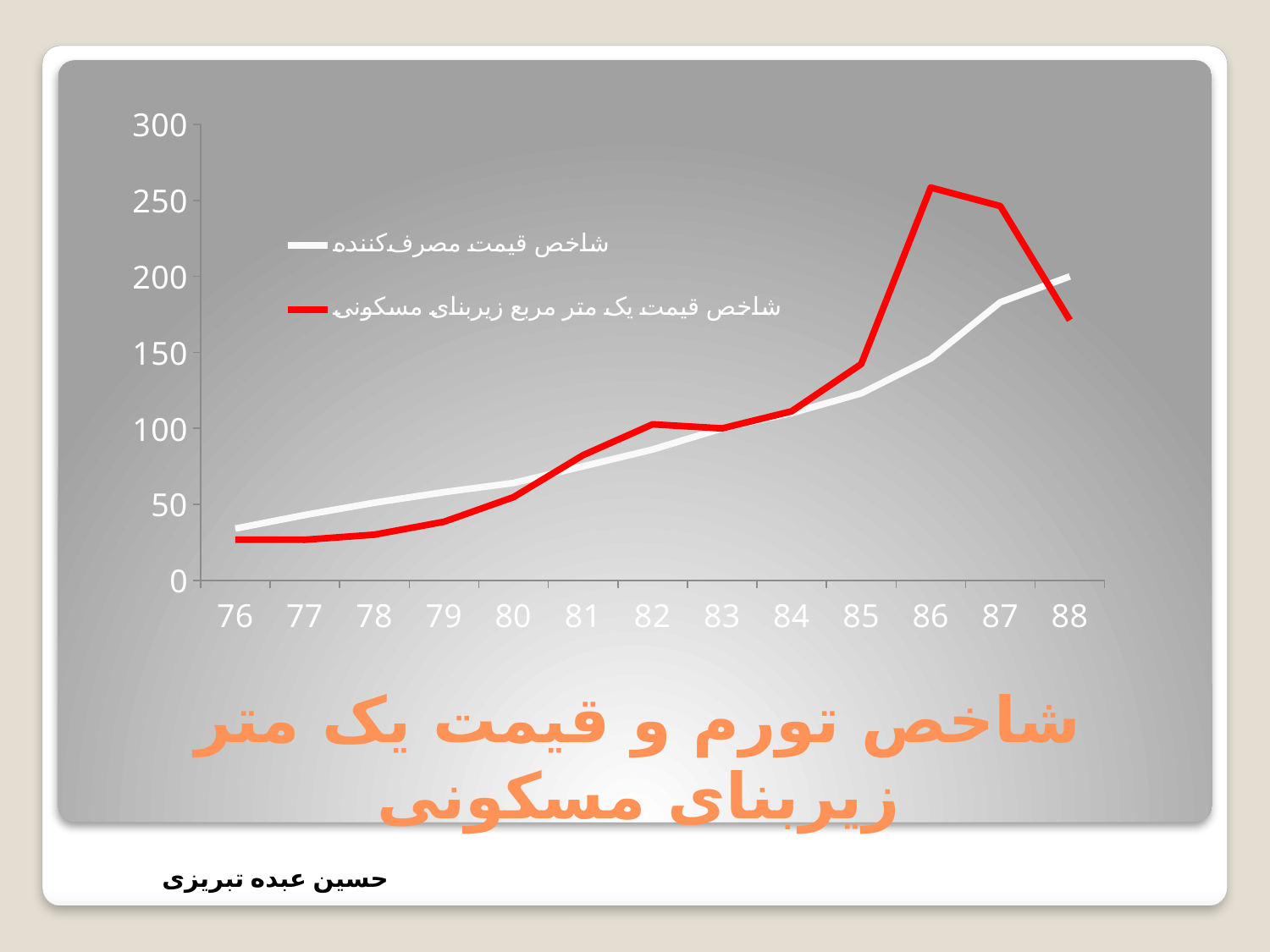
Does the white line (شاخص قیمت مصرف‌کننده) rise or fall from 76 to 88? rise In which year is the white line (شاخص قیمت مصرف‌کننده) at its lowest value? 76 Is the value of the red line in year 88 greater or less than 200? less What kind of chart is shown on the slide? line chart In which year does the white line (شاخص قیمت مصرف‌کننده) reach its highest value? 88 Is the value of the red line in year 86 greater or less than 250? greater In which year does the red line (شاخص قیمت یک متر مربع زیربنای مسکونی) reach its highest value? 86 In year 86, which series has the larger value, the red line or the white line? the red line How many years are shown along the x axis? 13 In year 88, which series has the larger value, the red line or the white line? the white line Is the value of the white line in year 76 greater or less than 50? less How many series does the legend list? 2